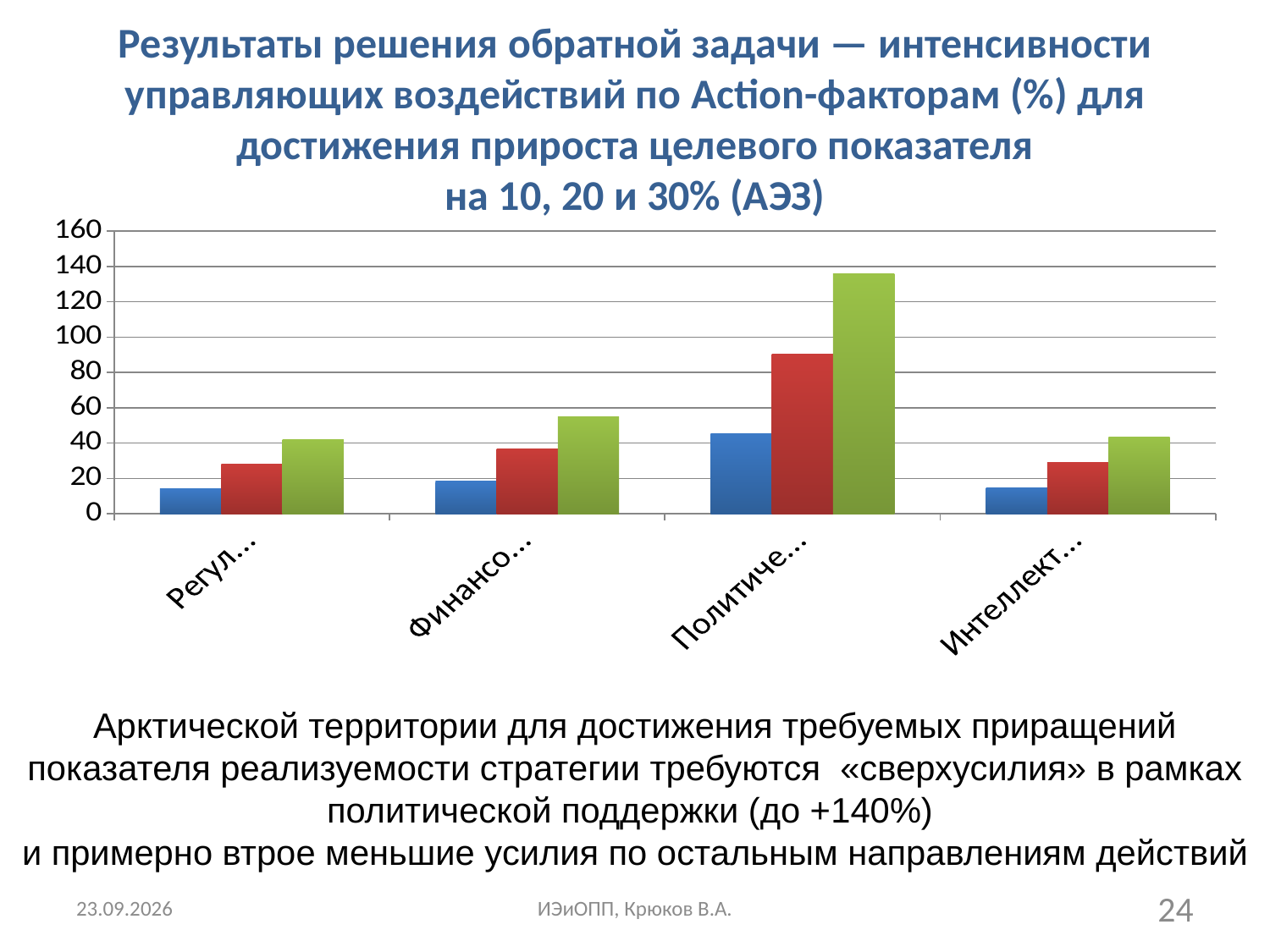
Which category group has the tallest bars? Политиче… (the third group) Is the green bar in the third group (Политиче…) greater or less than 140? less How many bars are there in each category group? 3 What kind of chart is shown on the slide? bar chart Which is larger: the green bar in the third group (Политиче…) or the green bar in the second group (Финансо…)? the green bar in the third group (Политиче…) What is the highest value shown on the vertical axis? 160 Within each category group, which coloured bar is the tallest? the green bar Is the green bar in the third group (Политиче…) greater or less than 120? greater Is the green bar in the second group (Финансо…) greater or less than 40? greater How many groups of bars (categories) are shown on the x axis? 4